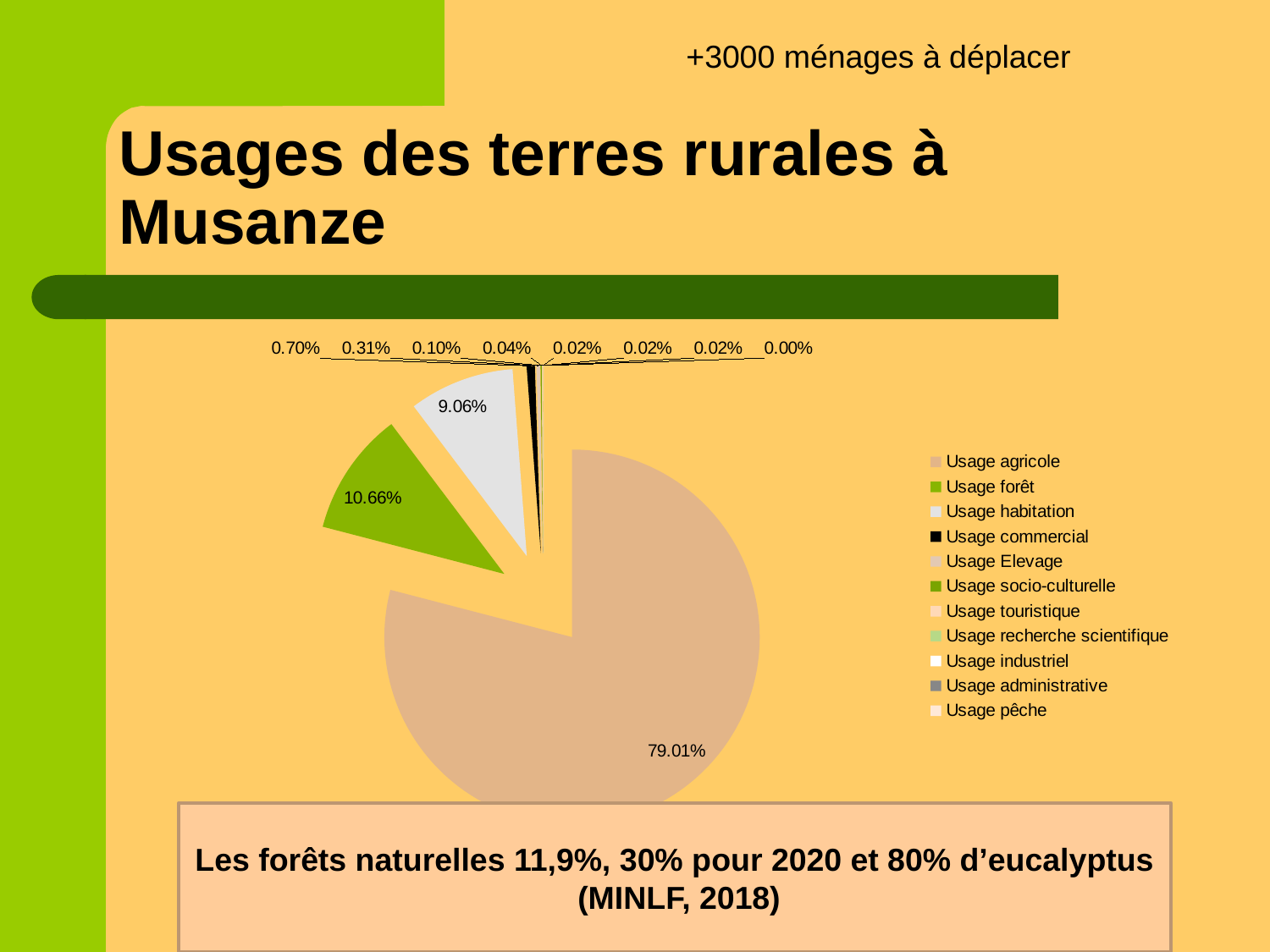
What share of the pie does Usage agricole represent? 79.01% How many categories does the legend of the pie chart list? 11 What kind of chart is shown on the slide? pie chart Which category has the largest slice of the pie chart? Usage agricole What is the smallest percentage value labelled on the pie chart? 0.00% Is the value for Usage agricole greater or less than 50%? greater Which is larger, the slice for Usage forêt or the slice for Usage habitation? Usage forêt What is the value shown for Usage habitation? 9.06% What is the difference between the Usage forêt share and the Usage habitation share? 1.60% What is the title of the slide containing the pie chart? Usages des terres rurales à Musanze What is the value shown for Usage forêt? 10.66% What is the difference between the Usage agricole share and the Usage forêt share? 68.35%